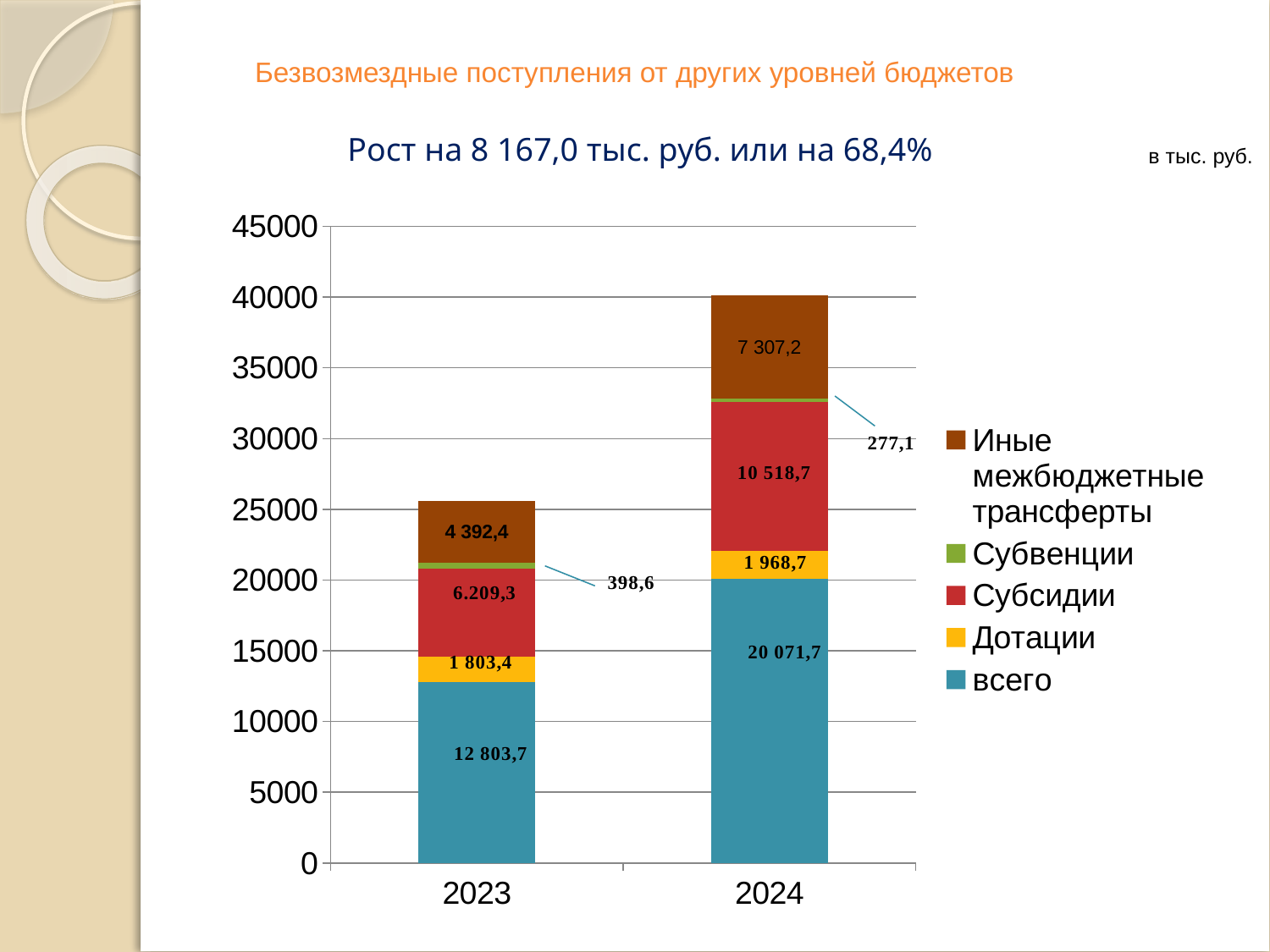
Which series is shown in red in the legend? Субсидии What is the value of Дотации for 2024? 1 968,7 What is the value of Иные межбюджетные трансферты for 2023? 4 392,4 What is the value of всего for 2023? 12 803,7 How many years (categories) are shown on the x axis? 2 Which year has the taller stacked bar, 2023 or 2024? 2024 How many series does the legend list? 5 By how much did Иные межбюджетные трансферты increase from 2023 to 2024? 2 914,8 What is the value of Субвенции for 2024? 277,1 What type of chart is shown on the slide? stacked bar chart What is the value of Субсидии for 2024? 10 518,7 Is the total height of the 2023 stacked bar greater or less than 30000? less